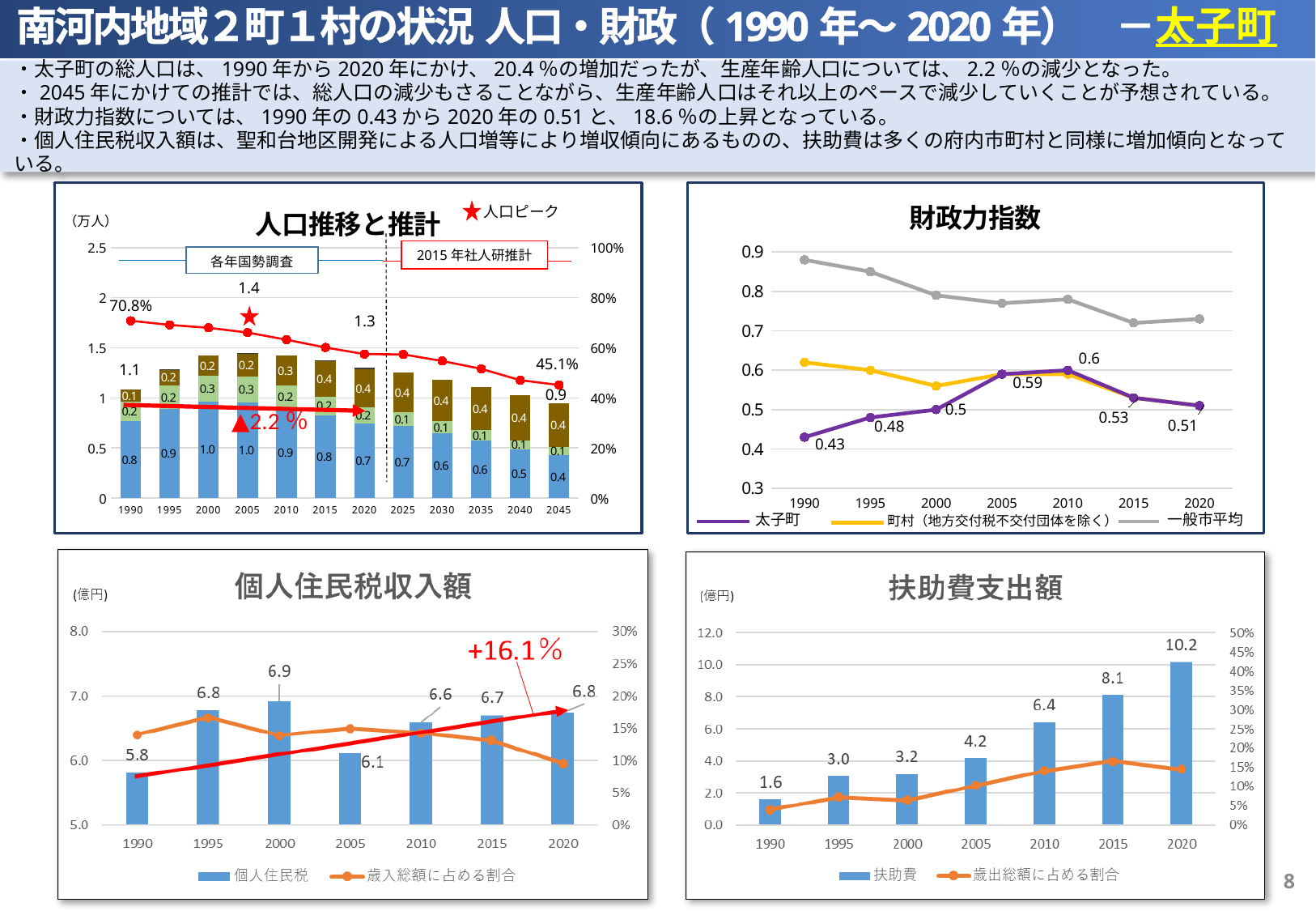
In the 扶助費支出額 chart, what is the difference between the 扶助費 values for 2020 and 2015? 2.1 In the 扶助費支出額 chart, do the 扶助費 bar values rise or fall from 1990 to 2020? rise In the 財政力指数 chart, how many series does the legend list? 3 In the 個人住民税収入額 chart, which is larger, the 個人住民税 value for 2005 or for 2010? 2010 In the 財政力指数 chart, what is the value for 太子町 in 2010? 0.6 In the 財政力指数 chart, is the value for 一般市平均 in 1990 greater or less than 0.8? greater In the 扶助費支出額 chart, which year has the lowest 扶助費 value? 1990 In the 人口推移と推計 chart, what is the total population value labelled for 2045? 0.9 In the 個人住民税収入額 chart, how many series does the legend list? 2 In the 扶助費支出額 chart, what is the value of 扶助費 for 2020? 10.2 In the 個人住民税収入額 chart, what is the 個人住民税 value for 2000? 6.9 In the 個人住民税収入額 chart, which year has the lowest 個人住民税 value? 1990